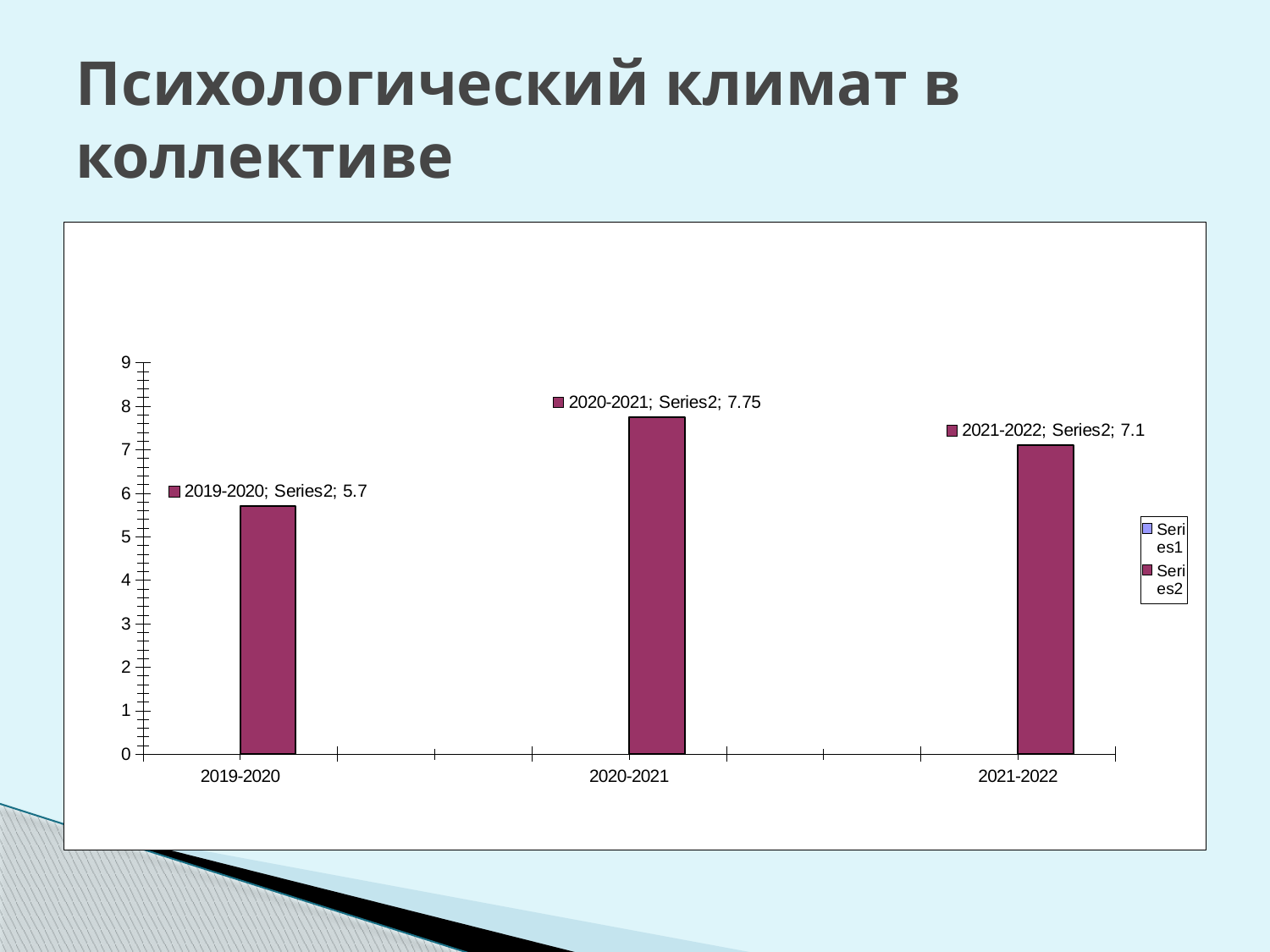
What is the value for 2020-2021? 7.75 What is the difference between the values for 2020-2021 and 2019-2020? 2.05 Which category has the lowest value? 2019-2020 How many categories are shown on the x axis? 3 Which category has the highest value? 2020-2021 How many series does the legend list? 2 Is the value for 2019-2020 greater or less than 6? less What is the value for 2019-2020? 5.7 What is the value for 2021-2022? 7.1 What kind of chart is shown on the slide? bar chart What is the difference between the values for 2020-2021 and 2021-2022? 0.65 Which is larger, the value for 2021-2022 or the value for 2019-2020? 2021-2022